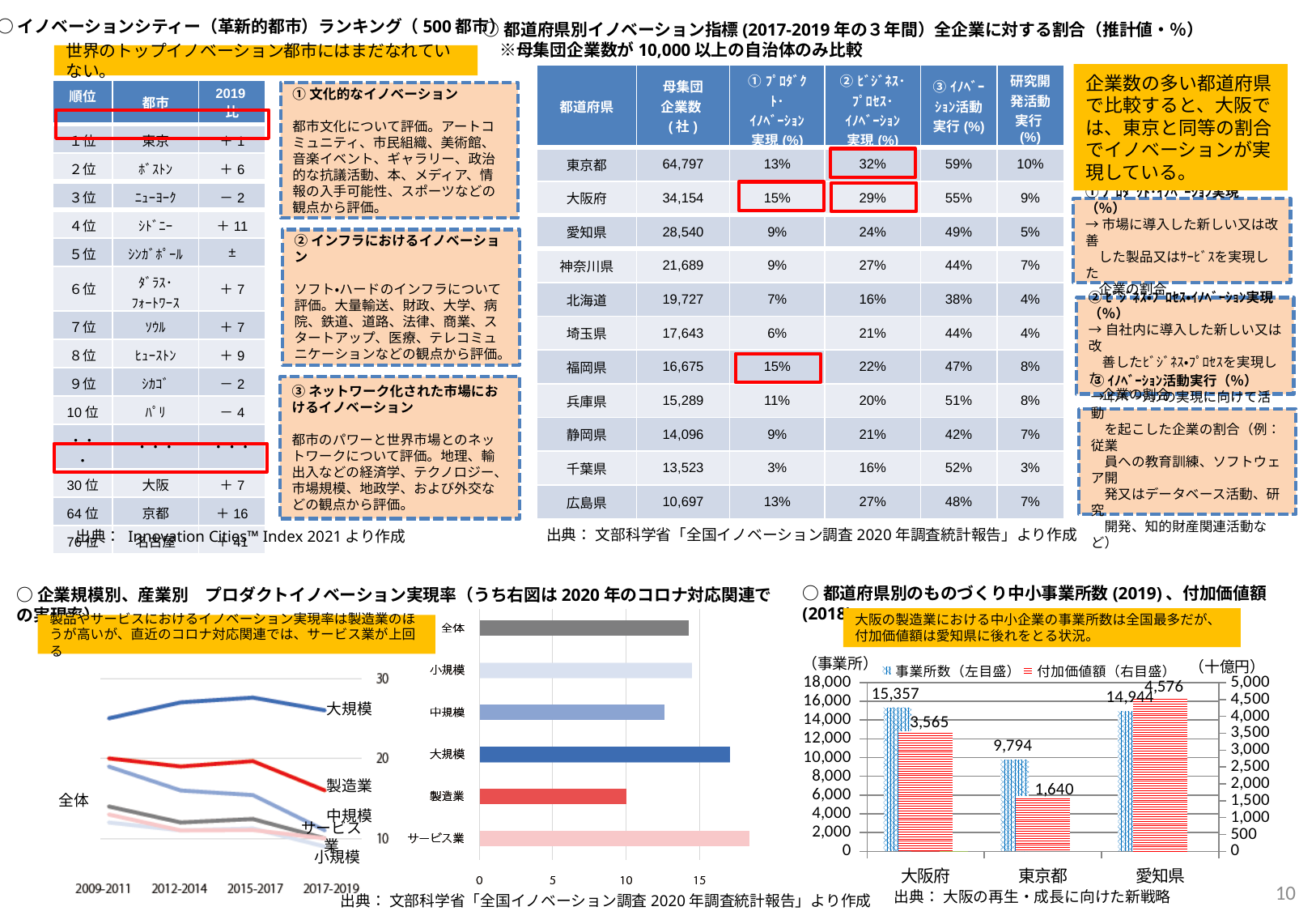
In the bottom-right chart on manufacturing SMEs by prefecture, how many series does the legend list? 2 In the bottom-middle horizontal bar chart of product innovation rates, is the value for 大規模 greater or less than 15? greater In the bottom-right chart on manufacturing SMEs by prefecture, what is the difference in the number of establishments between 大阪府 and 愛知県? 413 In the bottom-right chart on manufacturing SMEs by prefecture, which prefecture has the highest number of establishments (事業所数)? 大阪府 In the bottom-middle horizontal bar chart of product innovation rates, which is larger, the value for サービス業 or the value for 製造業? サービス業 In the bottom-right chart on manufacturing SMEs by prefecture, what is the value-added amount (付加価値額) for 愛知県? 4,576 In the bottom-left line chart, how many periods are shown on the x axis? 4 In the bottom-right chart on manufacturing SMEs by prefecture, what is the value-added amount (付加価値額) for 東京都? 1,640 In the bottom-right chart on manufacturing SMEs by prefecture, which prefecture has the lowest value-added amount (付加価値額)? 東京都 In the bottom-middle horizontal bar chart of product innovation rates, is the value for 中規模 greater or less than 15? less In the bottom-right chart on manufacturing SMEs by prefecture, how many prefectures are shown on the x axis? 3 In the bottom-right chart on manufacturing SMEs by prefecture, what is the number of establishments (事業所数) for 大阪府? 15,357